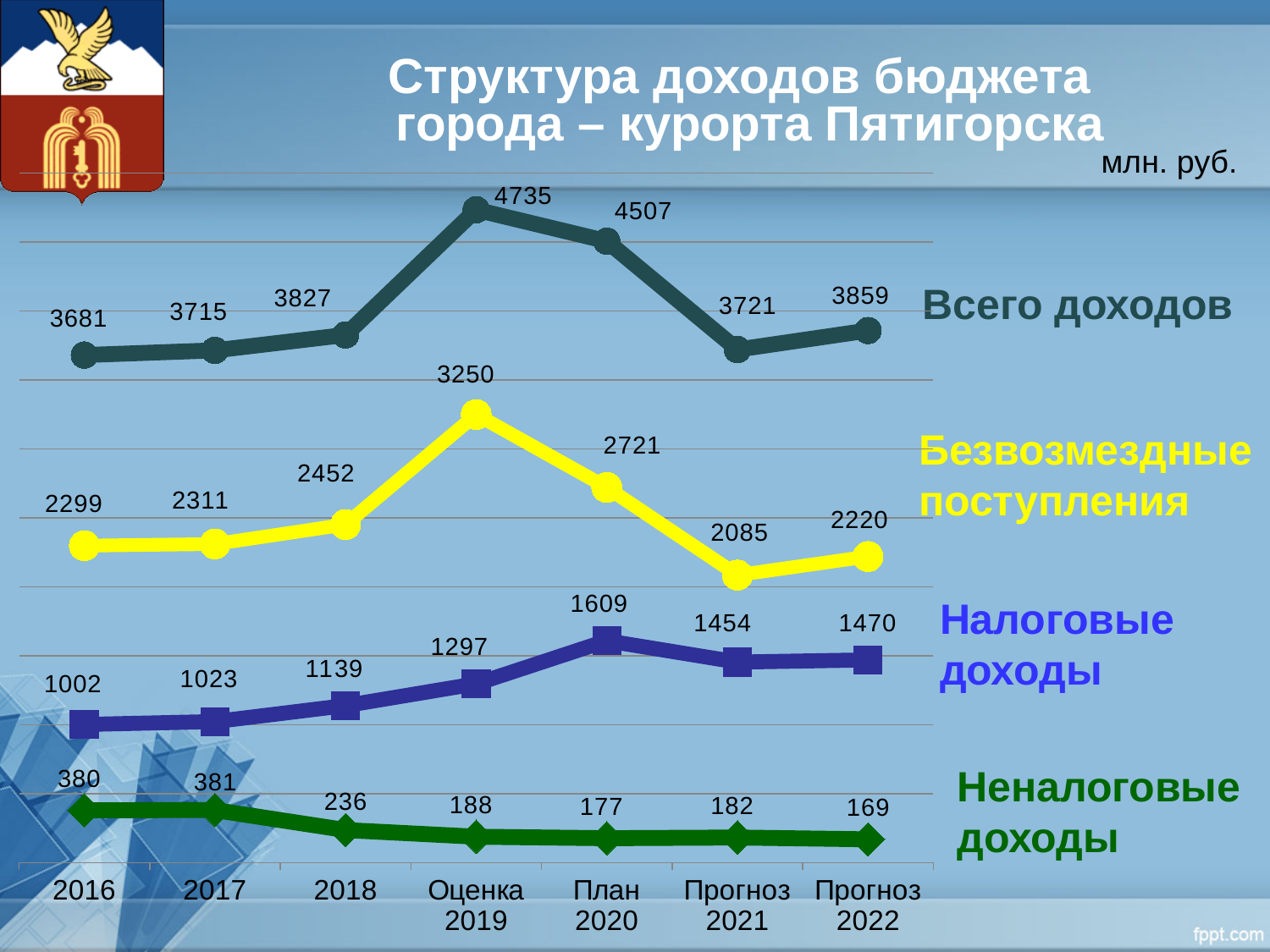
In which period is Всего доходов highest? Оценка 2019 What is the value of Неналоговые доходы for Прогноз 2022? 169 How many series are plotted on the chart? 4 In which period is Неналоговые доходы lowest? Прогноз 2022 What is the value of Всего доходов for Оценка 2019? 4735 What is the value of Налоговые доходы for План 2020? 1609 What kind of chart is shown on the slide? line chart What is the difference between Всего доходов in Оценка 2019 and in 2016? 1054 How many periods are shown on the x axis? 7 Which is larger: Налоговые доходы in Прогноз 2021 or in Прогноз 2022? Прогноз 2022 Does Неналоговые доходы rise or fall from 2016 to Прогноз 2022? fall What is the value of Безвозмездные поступления for 2018? 2452